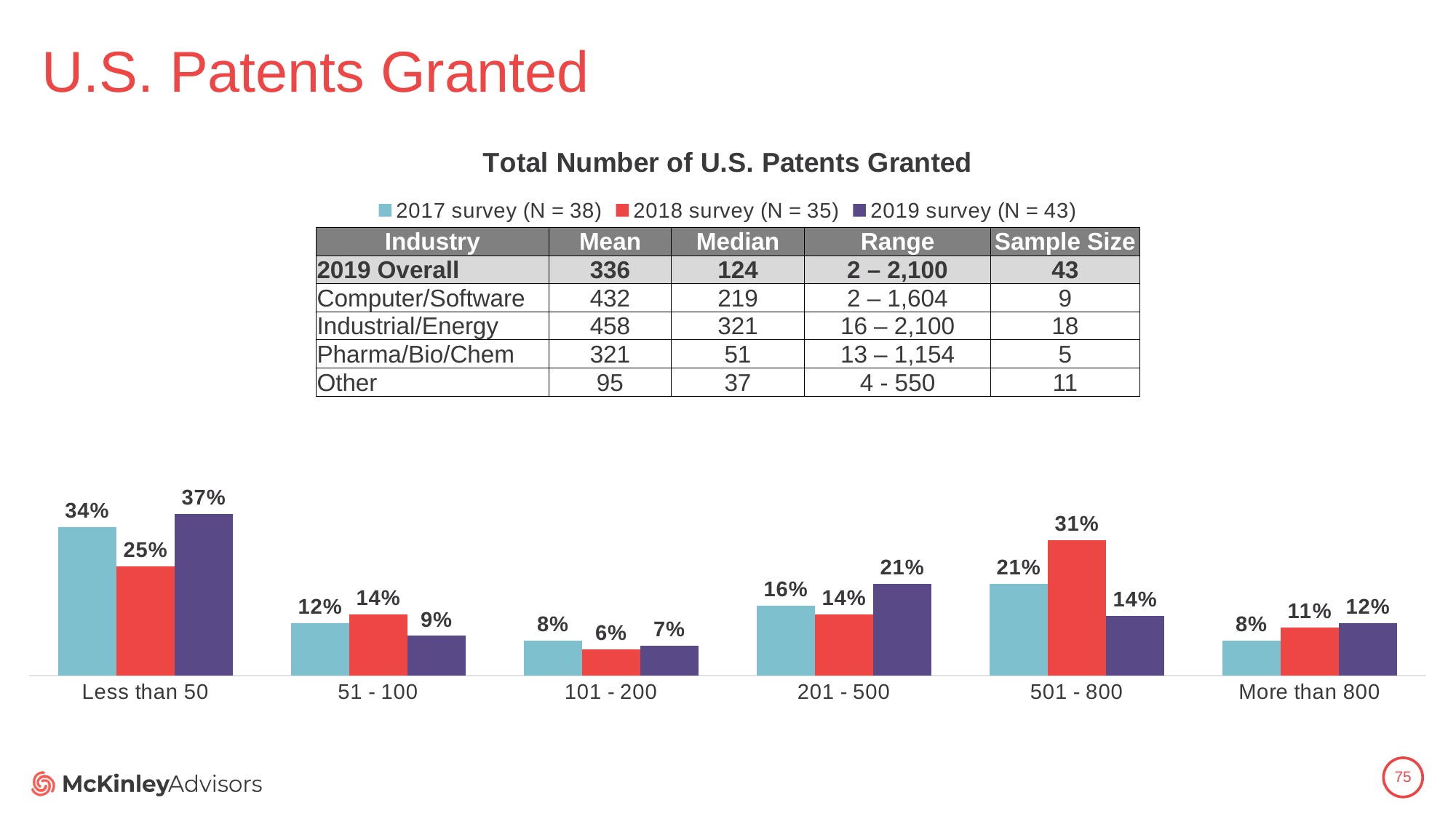
What is the difference between the 2019 survey and 2018 survey values in the 'Less than 50' category? 12% Which is larger in the '501 - 800' category: the 2017 survey value or the 2019 survey value? 2017 survey How many series does the chart legend list? 3 What is the value for the 2017 survey in the '201 - 500' category? 16% What kind of chart is shown on the slide? Bar chart How many categories are shown on the x axis of the chart? 6 Which category has the highest value for the 2017 survey? Less than 50 What is the sample size for the 2019 survey according to the legend? N = 43 What is the value for the 2018 survey in the '501 - 800' category? 31% What is the title of the chart? Total Number of U.S. Patents Granted Which category has the lowest value for the 2018 survey? 101 - 200 What is the value for the 2019 survey in the 'Less than 50' category? 37%